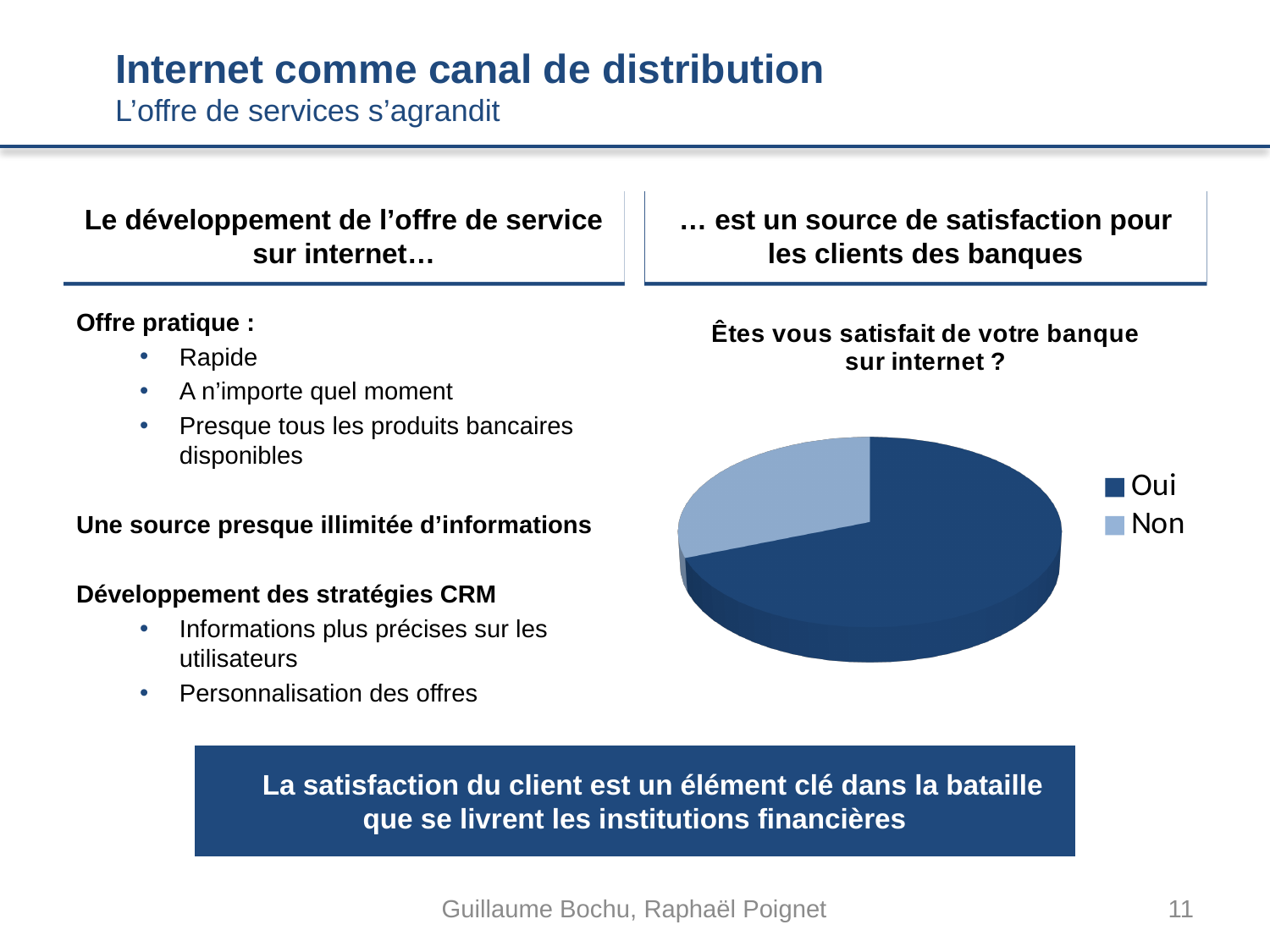
How many entries does the legend of the pie chart list? 2 Which legend entry is shown in the lighter blue colour in the pie chart? Non What is the title of the pie chart? Êtes vous satisfait de votre banque sur internet ? How many slices does the pie chart have? 2 Which category has the largest slice in the pie chart? Oui What kind of chart is shown on the slide? pie chart Which category has the smallest slice in the pie chart? Non Which slice is larger in the pie chart, Oui or Non? Oui